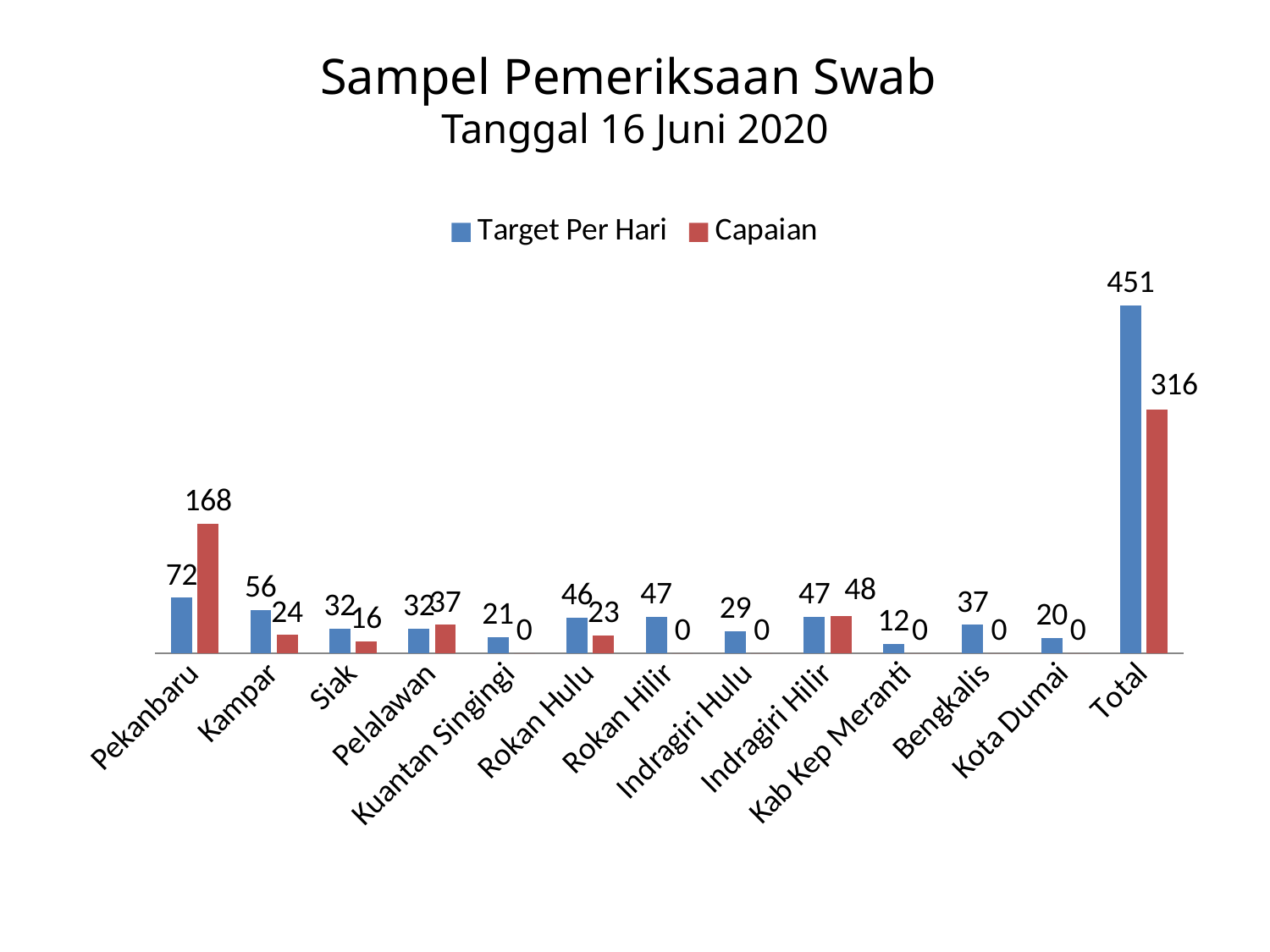
What kind of chart is shown on the slide? Bar chart How many series does the legend list? 2 What is the Capaian value for Pelalawan? 37 What is the Target Per Hari value for Total? 451 What is the Target Per Hari value for Kampar? 56 Excluding Total, which category has the highest Capaian value? Pekanbaru What is the title of the chart? Sampel Pemeriksaan Swab Tanggal 16 Juni 2020 What is the difference between the Target Per Hari and Capaian values for Total? 135 Which is larger for Kampar, Target Per Hari or Capaian? Target Per Hari Which category has the lowest Target Per Hari value? Kab Kep Meranti What is the Capaian value for Pekanbaru? 168 How many categories are shown on the x axis? 13